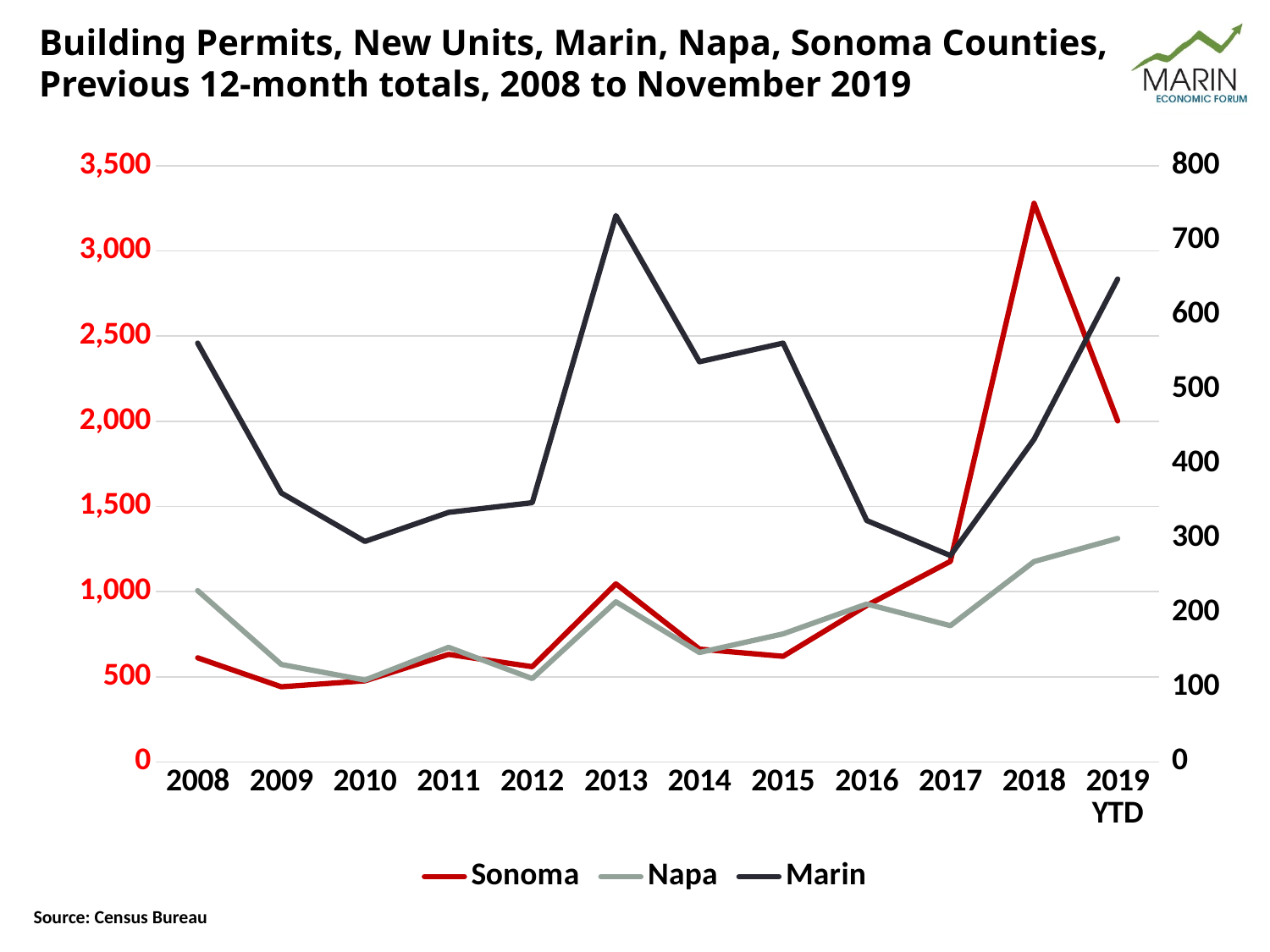
Which is larger for Sonoma: the value in 2017 or the value in 2018? 2018 In which year does the Marin line reach its highest value? 2013 Is the Sonoma value for 2009 greater or less than 500 on the left axis? less In which year does the Sonoma line reach its highest value? 2018 How many series does the legend list? 3 In which year does the Sonoma line reach its lowest value? 2009 What colour is the Sonoma line in the legend? red Is the Sonoma value for 2018 greater or less than 3,000 on the left axis? greater What kind of chart is shown on the slide? line chart How many years (points) are shown along the x axis? 12 Does the Sonoma line rise or fall from 2015 to 2018? rise Is the Marin value for 2013 greater or less than 700 on the right axis? greater